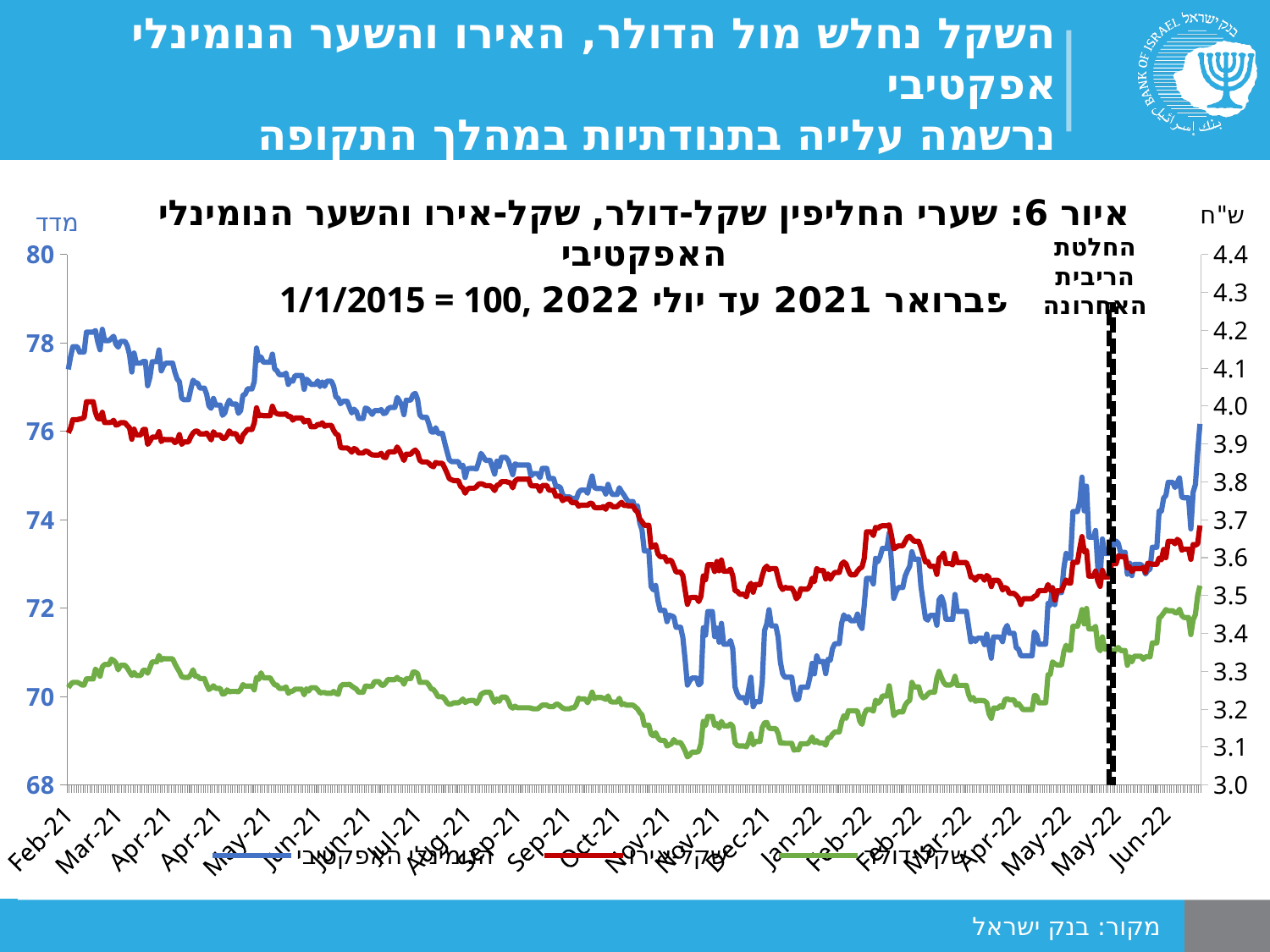
Does the green (שקל-דולר) line rise or fall between Apr-22 and Jun-22? rise Is the value of the red (שקל-אירו) line at Nov-21 greater or less than 3.7 on the right axis? less Does the blue (השער הנומינלי האפקטיבי) line rise or fall between Feb-21 and Nov-21? fall How many series does the legend of the chart list? 3 What does the vertical dashed black line on the chart mark, according to its annotation? החלטת הריבית האחרונה On the right axis, which line is higher at Feb-21: the red (שקל-אירו) line or the green (שקל-דולר) line? the red (שקל-אירו) line What kind of chart is shown on the slide? Line chart Is the value of the green (שקל-דולר) line at Feb-21 greater or less than 3.5 on the right axis? less Is the value of the blue (השער הנומינלי האפקטיבי) line at Feb-21 greater or less than 76 on the left axis? greater What is the label of the left vertical axis of the chart? מדד